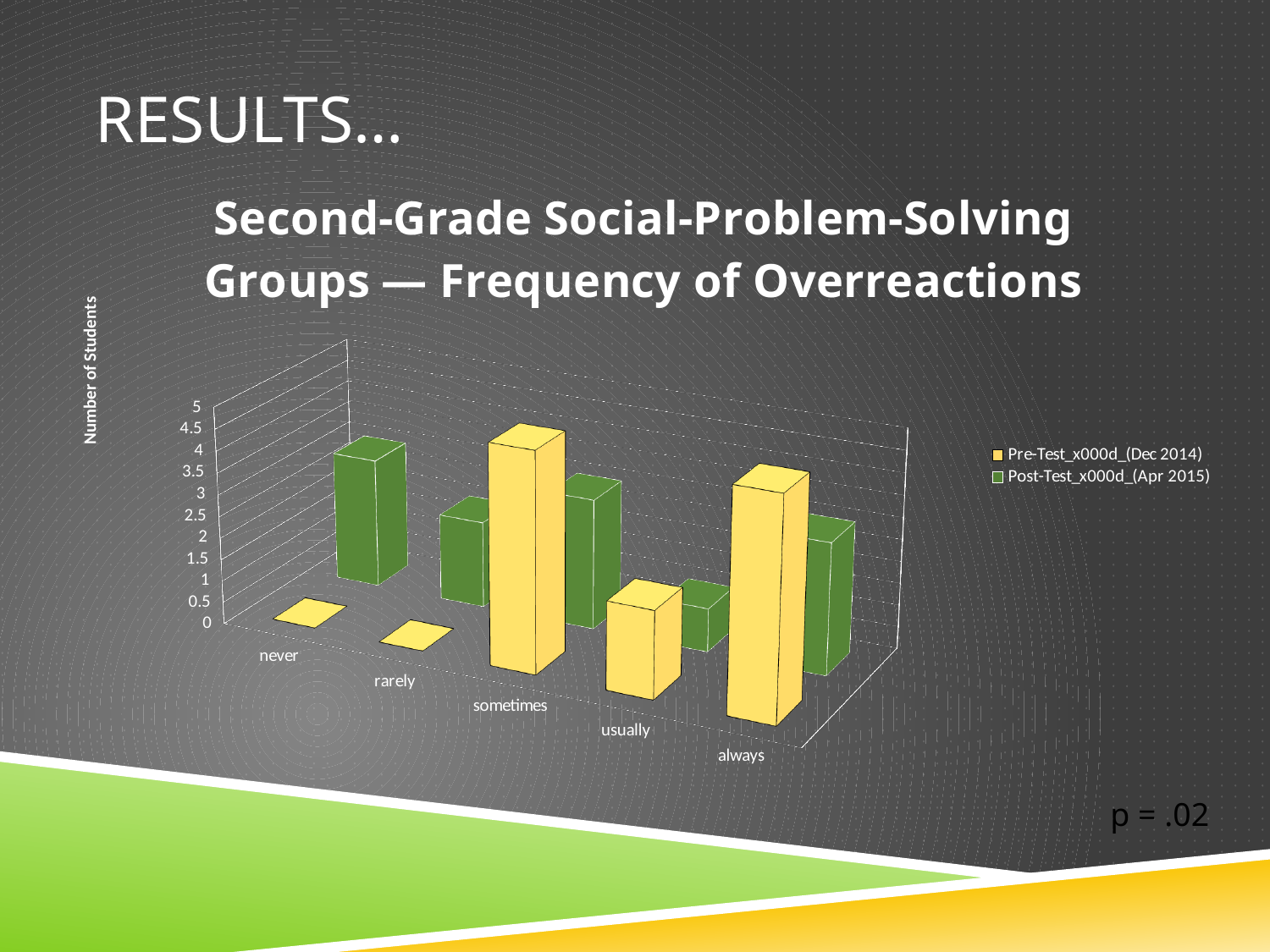
Is the Pre-Test (Dec 2014) value for 'sometimes' greater or less than 3? greater What is the Pre-Test (Dec 2014) value for 'rarely'? 0 What kind of chart is shown on the slide? bar chart Which is larger for the Pre-Test (Dec 2014) series: 'sometimes' or 'usually'? sometimes Is the Pre-Test (Dec 2014) value for 'usually' greater or less than 4? less Is the Post-Test (Apr 2015) value for 'usually' greater or less than 3? less For 'always', which series has the larger value: Pre-Test (Dec 2014) or Post-Test (Apr 2015)? Pre-Test (Dec 2014) How many categories are shown along the x axis? 5 How many series does the legend list? 2 What is the title of the vertical axis? Number of Students What is the Pre-Test (Dec 2014) value for 'never'? 0